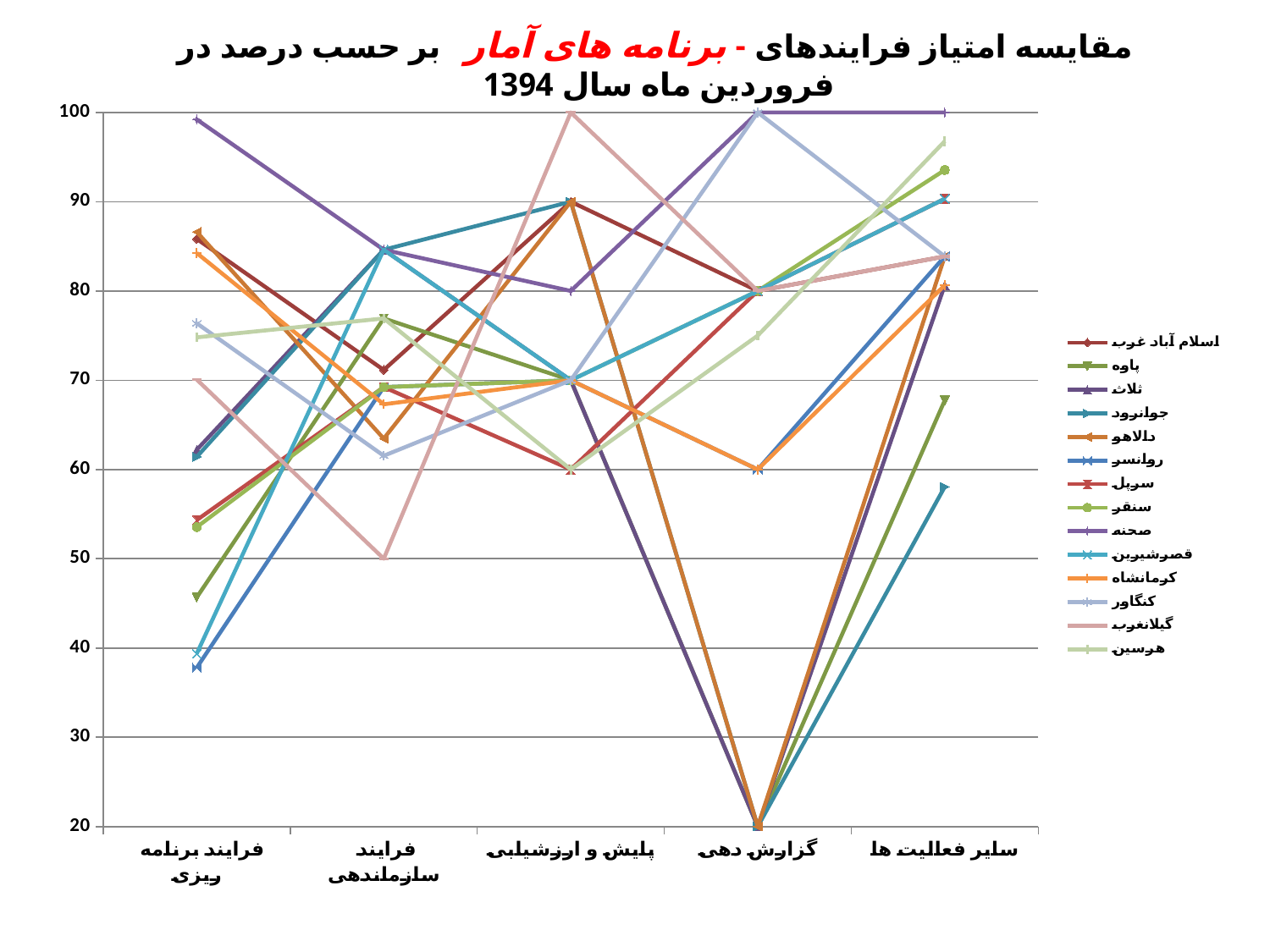
Is the value for هرسین at پایش و ارزشیابی greater or less than 70? less Is the value for گیلانغرب at پایش و ارزشیابی greater or less than 90? greater What kind of chart is shown on the slide? line chart How many series does the legend list? 14 What is the highest value shown on the y axis? 100 What is the last category on the x axis? سایر فعالیت ها Is the value for گیلانغرب at فرایند برنامه ریزی greater or less than 80? less How many categories are shown along the x axis? 5